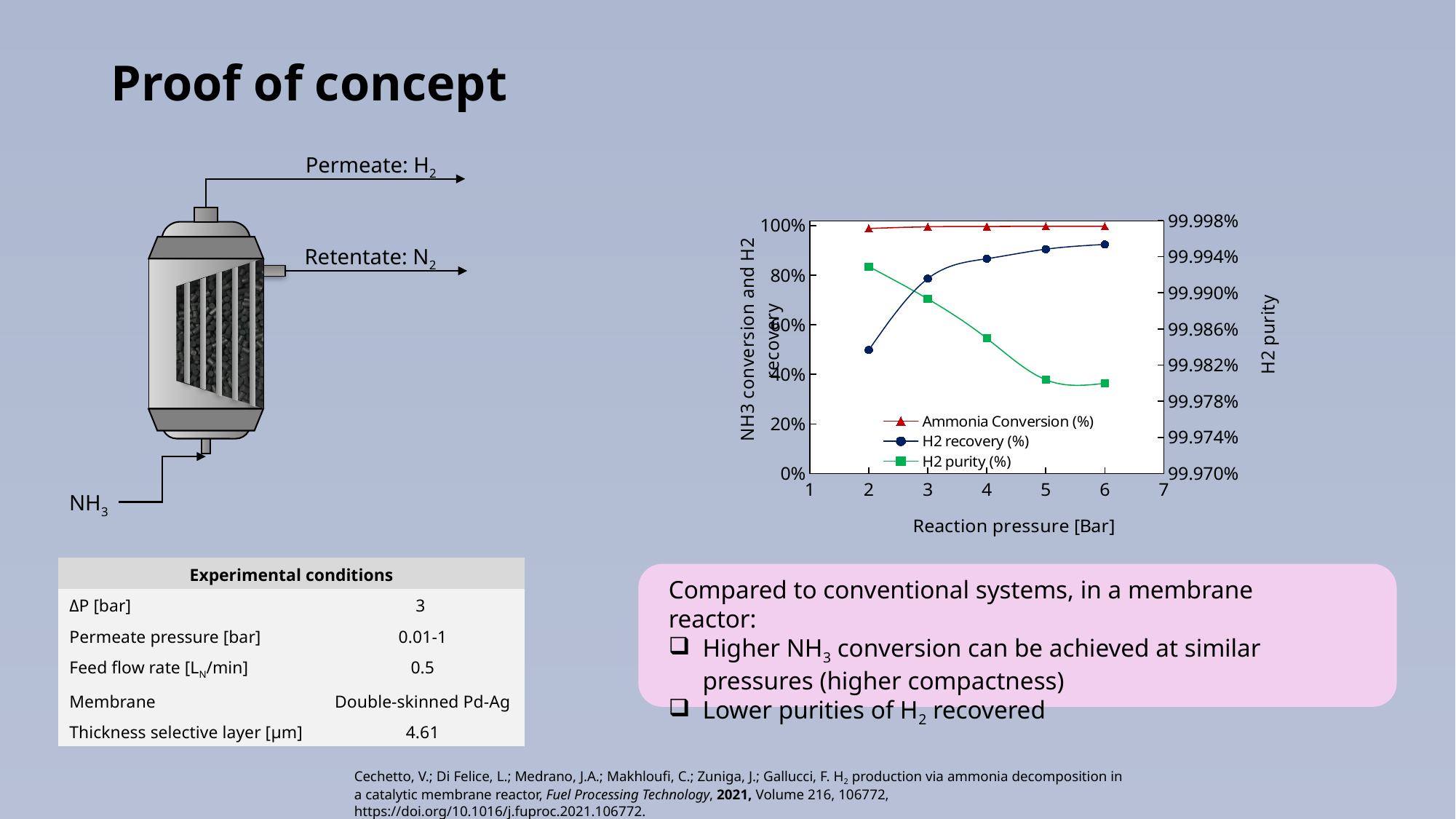
Which is larger: H2 recovery (%) at 3 bar or H2 recovery (%) at 5 bar? H2 recovery at 5 bar Does H2 purity (%) rise or fall as reaction pressure increases from 2 to 6 bar? Fall What is the title of the x axis of the chart? Reaction pressure [Bar] Is the Ammonia Conversion (%) value at a reaction pressure of 4 bar greater or less than 80%? greater At which reaction pressure is H2 recovery (%) lowest? 2 bar How many series does the chart legend list? 3 How many data points are plotted for the H2 recovery (%) series? 5 At which reaction pressure is H2 purity (%) highest? 2 bar Is the H2 recovery (%) value at a reaction pressure of 6 bar greater or less than 80%? greater Does H2 recovery (%) rise or fall as reaction pressure increases from 2 to 6 bar? Rise What kind of chart is shown on the slide? Line chart Is the H2 recovery (%) value at a reaction pressure of 2 bar greater or less than 60%? less